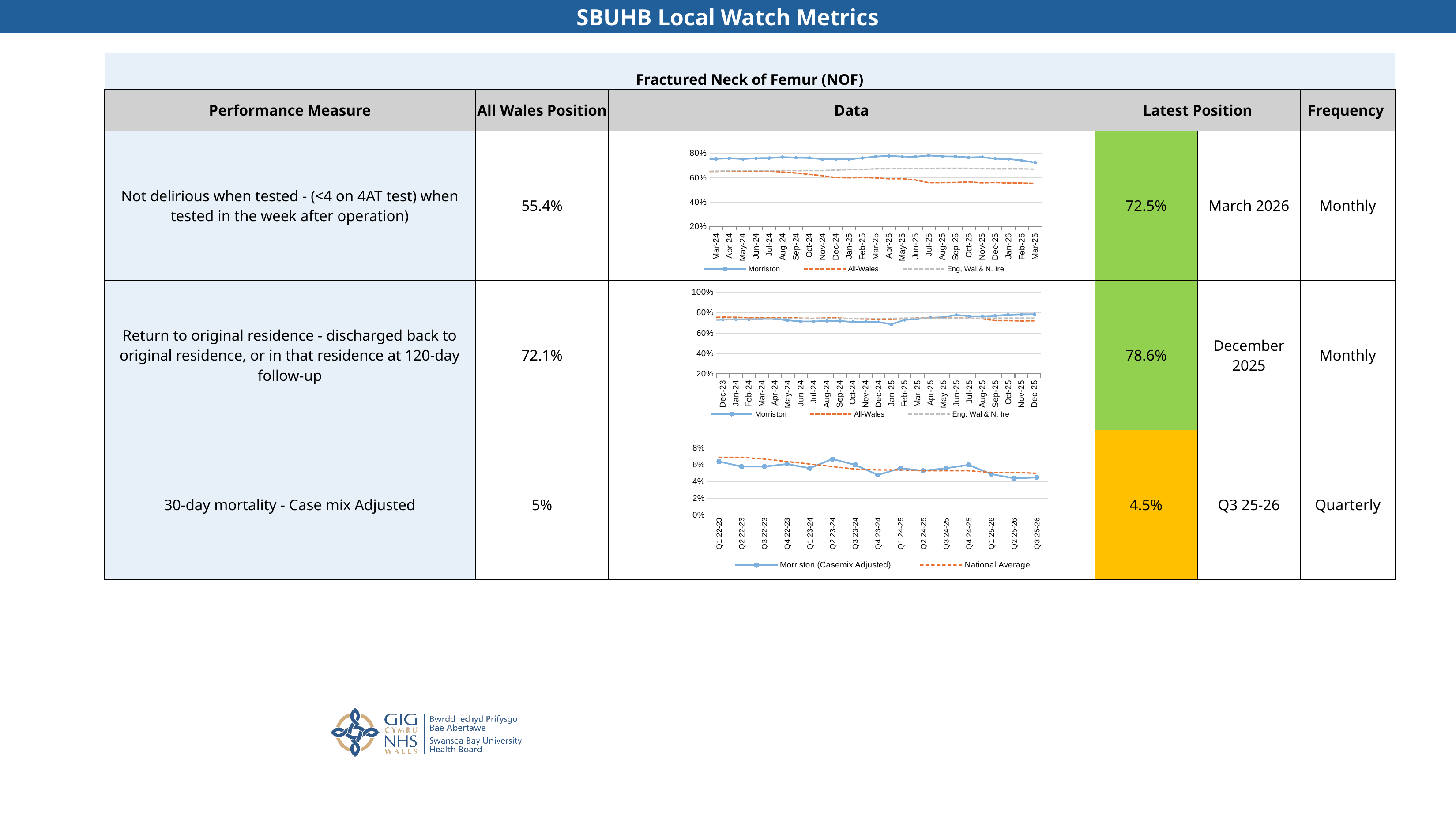
How many quarterly points are plotted along the x axis of the bottom chart (30-day mortality)? 15 What type of chart is shown in the Data column for the '30-day mortality - Case mix Adjusted' row? Line chart In the bottom chart (30-day mortality), is the Morriston (Casemix Adjusted) value for Q2 23-24 greater or less than 6%? greater How many series does the legend list in the top chart (Not delirious when tested)? 3 In the bottom chart (30-day mortality), what is the name of the dashed orange series in the legend? National Average In the top chart (Not delirious when tested), is the All-Wales value for Mar-26 greater or less than 60%? less In the middle chart (Return to original residence), is the Morriston value for Dec-25 greater or less than 60%? greater In the top chart (Not delirious when tested), which series is higher at Mar-26: Morriston or All-Wales? Morriston How many monthly points are plotted along the x axis of the middle chart (Return to original residence), from Dec-23 to Dec-25? 25 How many series does the legend list in the bottom chart (30-day mortality)? 2 In the bottom chart (30-day mortality), does the Morriston (Casemix Adjusted) line overall rise or fall from Q1 22-23 to Q3 25-26? fall